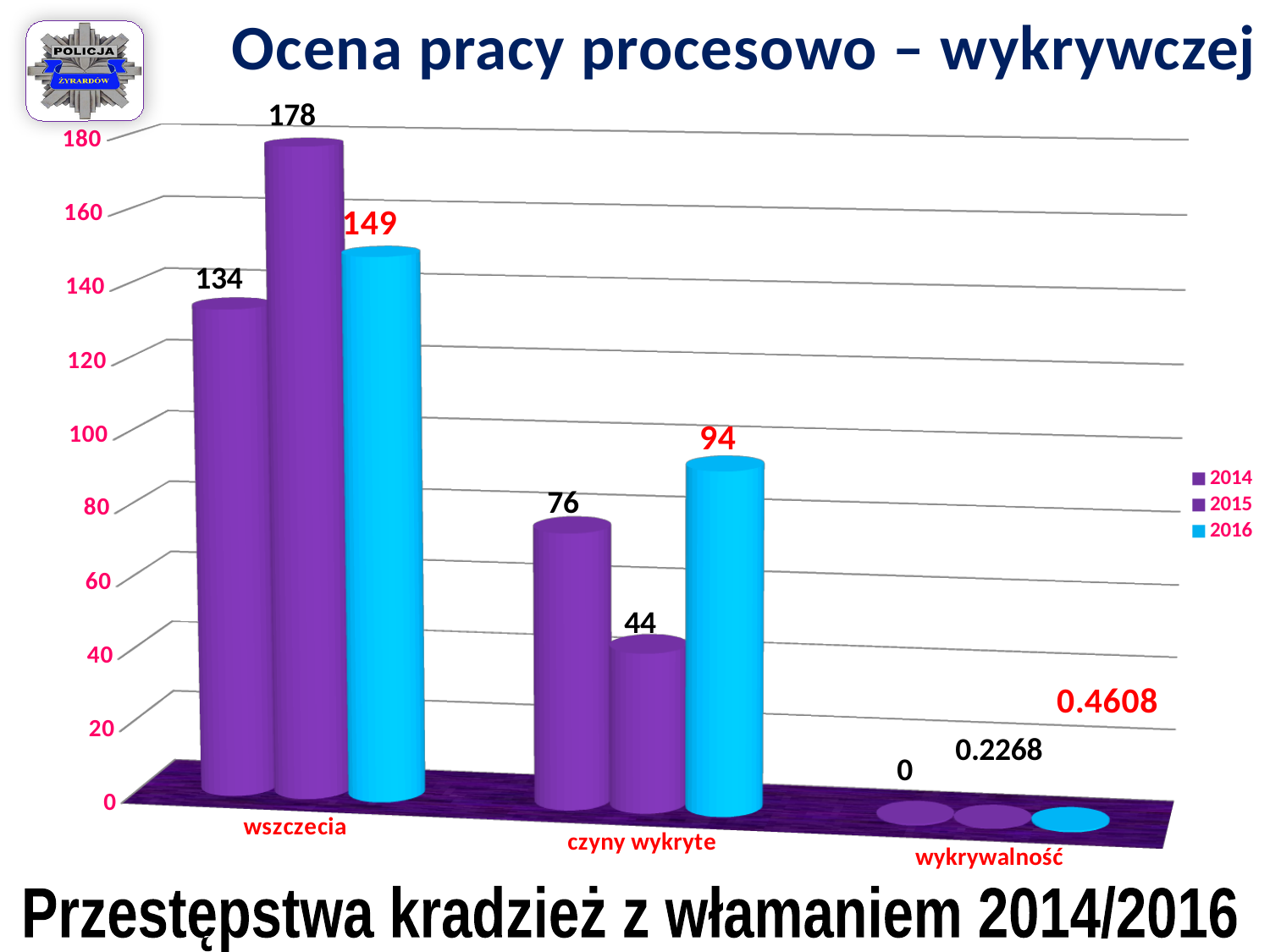
What is the value for wykrywalność in 2015? 0.2268 Which year has the highest value for wszczecia? 2015 How many series does the legend list? 3 What is the value for czyny wykryte in 2016? 94 What is the difference between the 2016 and 2014 values for czyny wykryte? 18 What kind of chart is shown on the slide? Bar chart What is the value for wszczecia in 2015? 178 How many categories are shown on the x axis? 3 Which is larger: the 2016 value for wszczecia or the 2014 value for wszczecia? 2016 What is the difference between the 2015 and 2014 values for wszczecia? 44 Which year has the lowest value for czyny wykryte? 2015 What is the value for wykrywalność in 2016? 0.4608